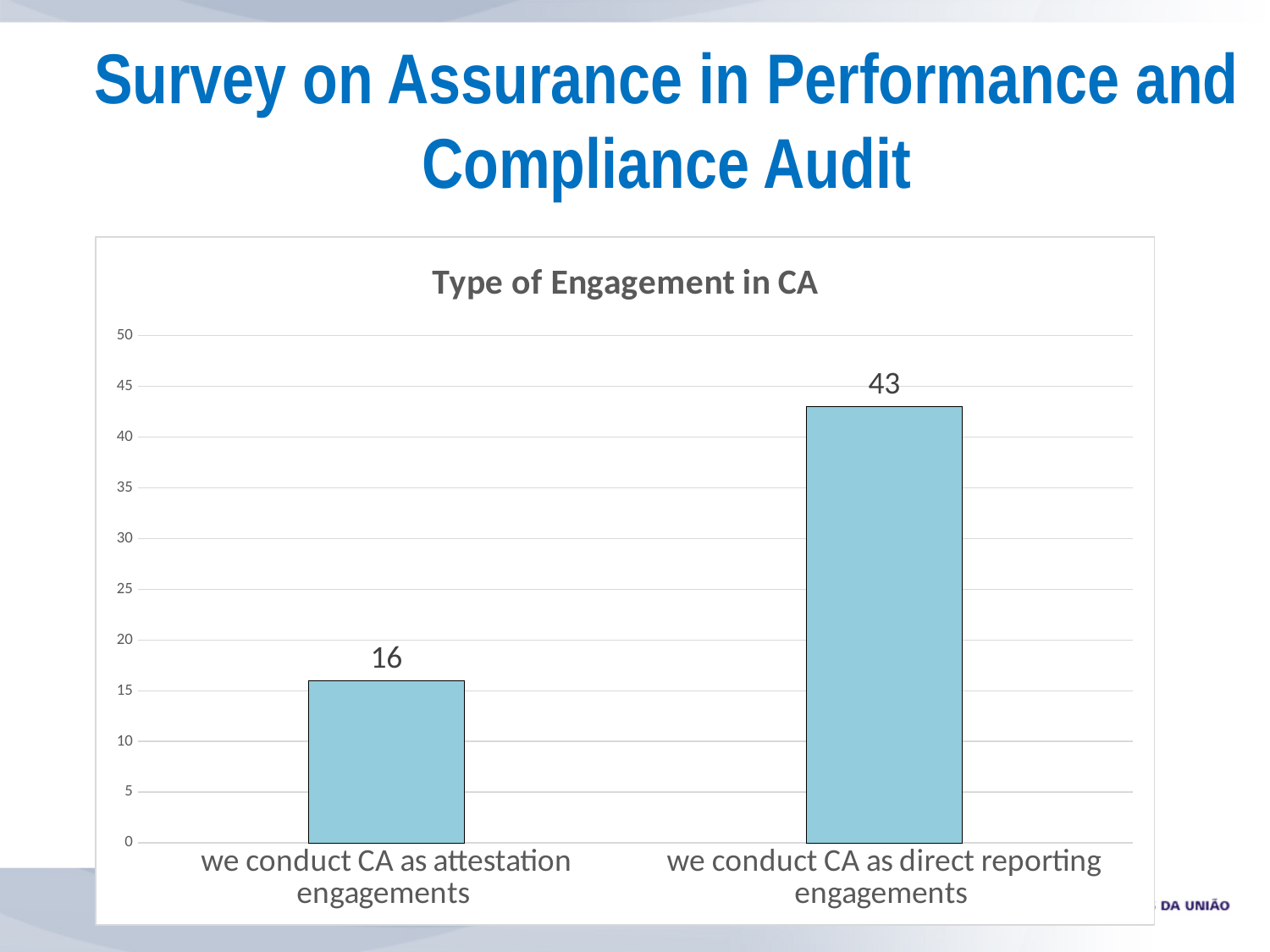
Is the value for "we conduct CA as direct reporting engagements" greater or less than 40? greater What is the title of the chart? Type of Engagement in CA What kind of chart is shown on the slide? bar chart Which is larger: the value for attestation engagements or the value for direct reporting engagements? we conduct CA as direct reporting engagements How many categories are shown in the chart? 2 Which category has the highest value? we conduct CA as direct reporting engagements What is the maximum value shown on the vertical axis? 50 What is the value for "we conduct CA as direct reporting engagements"? 43 Which category has the lowest value? we conduct CA as attestation engagements What is the value for "we conduct CA as attestation engagements"? 16 Is the value for "we conduct CA as attestation engagements" greater or less than 20? less What is the difference between the values for direct reporting engagements and attestation engagements? 27